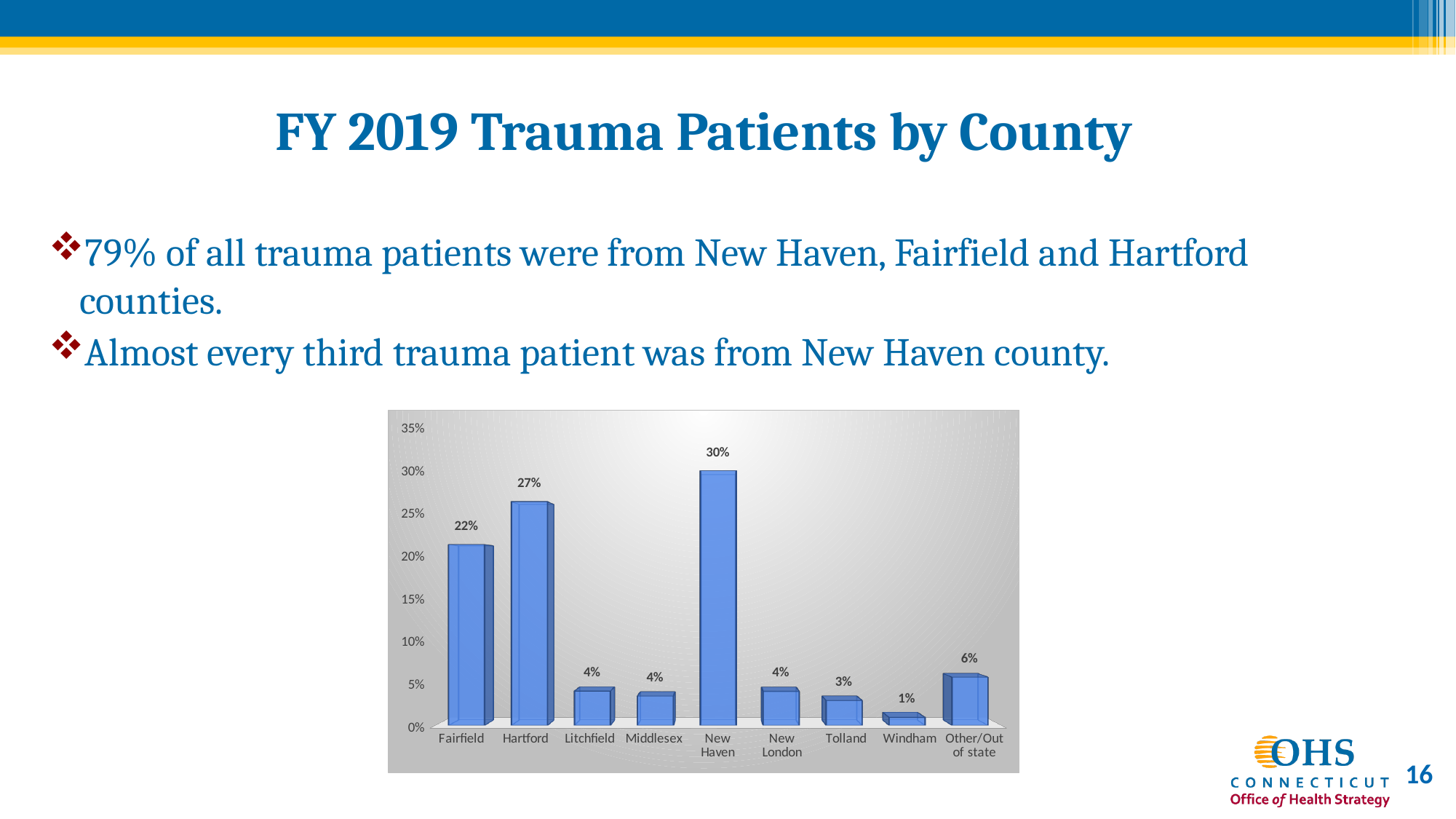
What is the difference between the values for New Haven and Fairfield? 8% What is the value shown for Windham? 1% Which category has the lowest value in the chart? Windham What is the highest value labelled on the vertical axis of the chart? 35% What is the value shown for Other/Out of state? 6% What percentage of trauma patients were from New Haven county? 30% Which county has the highest share of trauma patients? New Haven Is the value for Fairfield greater or less than 20%? greater How many categories are shown on the x axis of the chart? 9 What kind of chart is shown on the slide? Bar chart Which is larger, the value for Hartford or the value for Fairfield? Hartford What percentage of trauma patients were from Hartford county? 27%